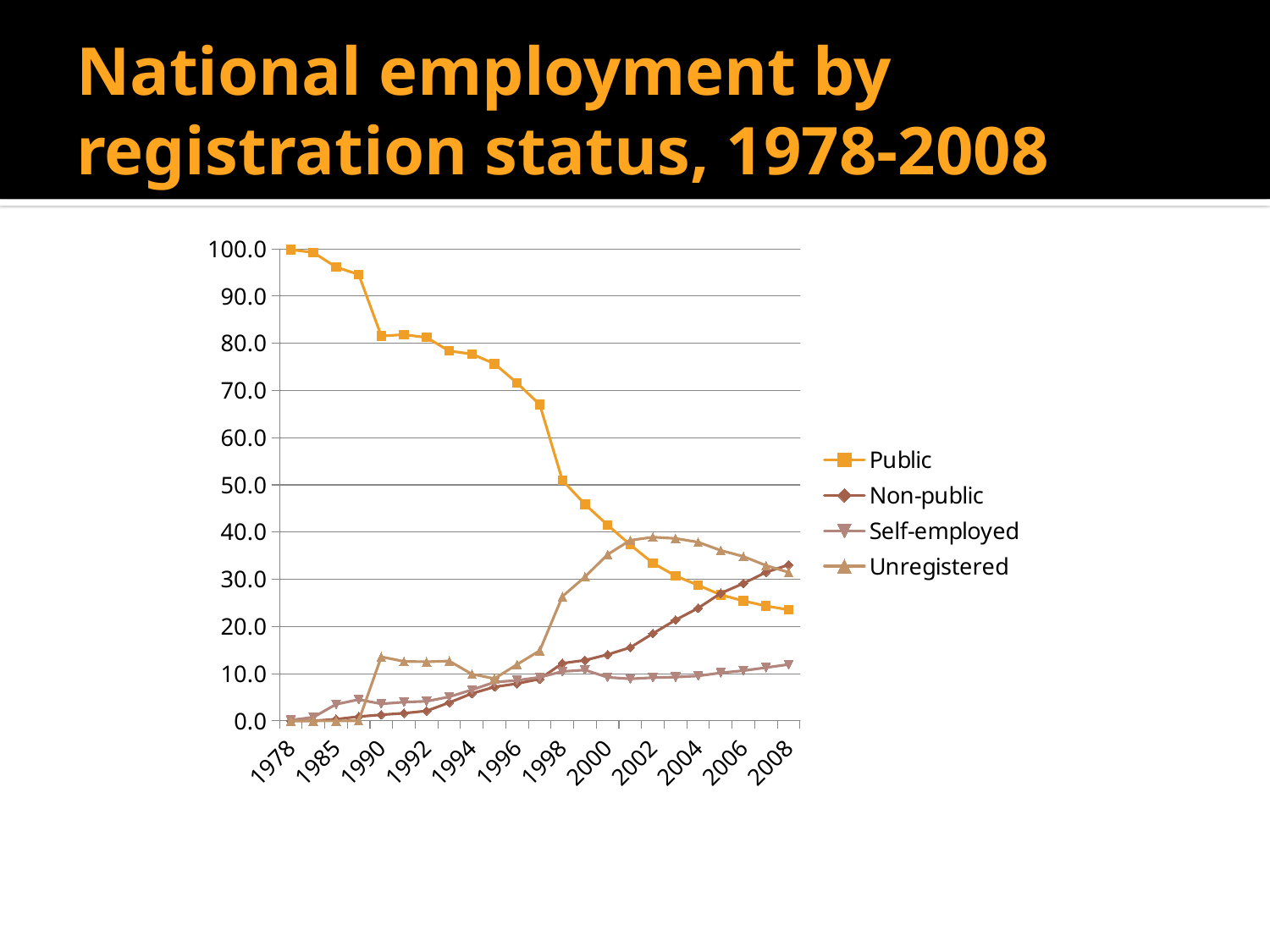
How many year labels are shown on the x axis? 12 Does the Non-public series rise or fall from 1978 to 2008? rise Which series has the highest value in 1978? Public In 2008, which is larger: the value for Non-public or the value for Self-employed? Non-public What kind of chart is shown on the slide? line chart Is the value for Self-employed in 2008 greater or less than 20.0? less Is the value for Public in 2008 greater or less than 30.0? less Which series has the lowest value in 2008? Self-employed Does the Public series rise or fall from 1978 to 2008? fall Is the value for Unregistered in 2002 greater or less than 30.0? greater How many series does the legend list? 4